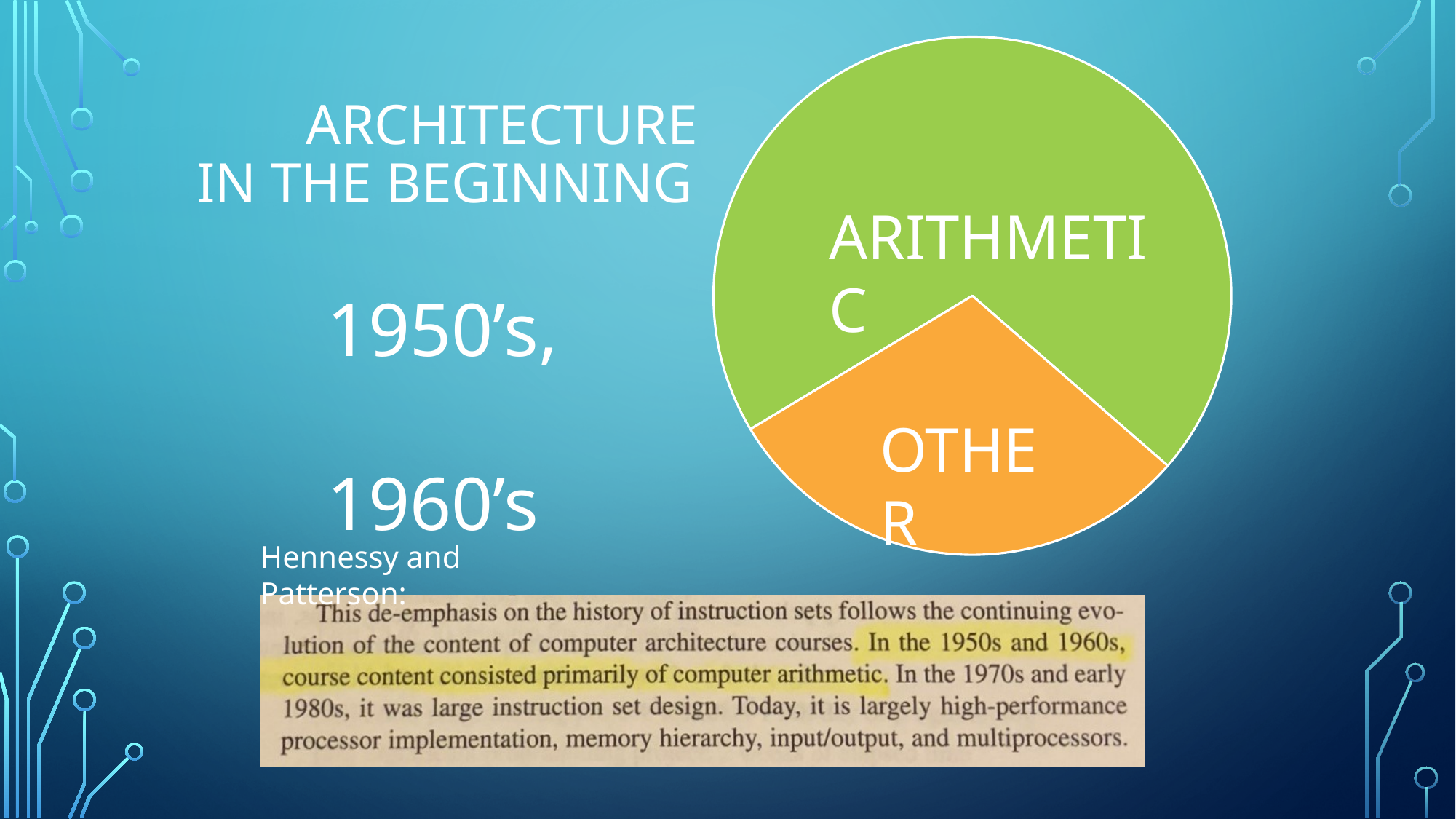
What colour is the ARITHMETIC slice of the pie chart? green Which slice of the pie chart is the largest? ARITHMETIC What kind of chart is shown on the slide? pie chart What colour is the OTHER slice of the pie chart? orange Which slice is larger in the pie chart, ARITHMETIC or OTHER? ARITHMETIC How many slices does the pie chart have? 2 Which slice of the pie chart is the smallest? OTHER